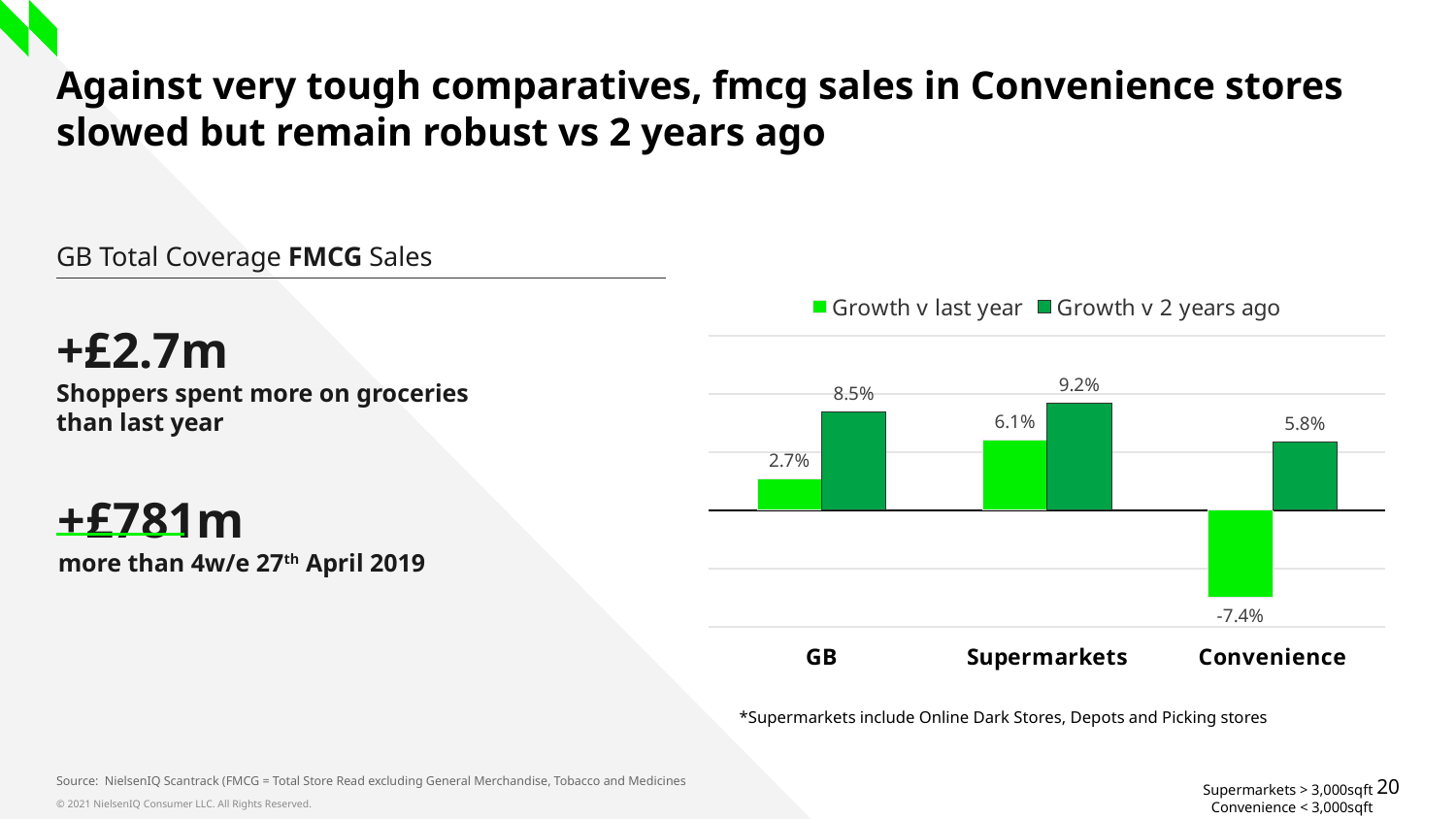
Which category has the highest 'Growth v 2 years ago' value? Supermarkets What is the 'Growth v last year' value for Convenience? -7.4% Which is larger for Supermarkets: 'Growth v last year' or 'Growth v 2 years ago'? Growth v 2 years ago How many categories are shown on the x axis of the chart? 3 What is the difference between the 'Growth v 2 years ago' and 'Growth v last year' values for GB? 5.8% What is the 'Growth v last year' value for GB? 2.7% What kind of chart is shown on the slide? Bar chart What is the 'Growth v 2 years ago' value for Supermarkets? 9.2% Which category has the lowest 'Growth v last year' value? Convenience What is the 'Growth v 2 years ago' value for Convenience? 5.8% What are the two series named in the chart legend? Growth v last year; Growth v 2 years ago How many series does the chart legend list? 2